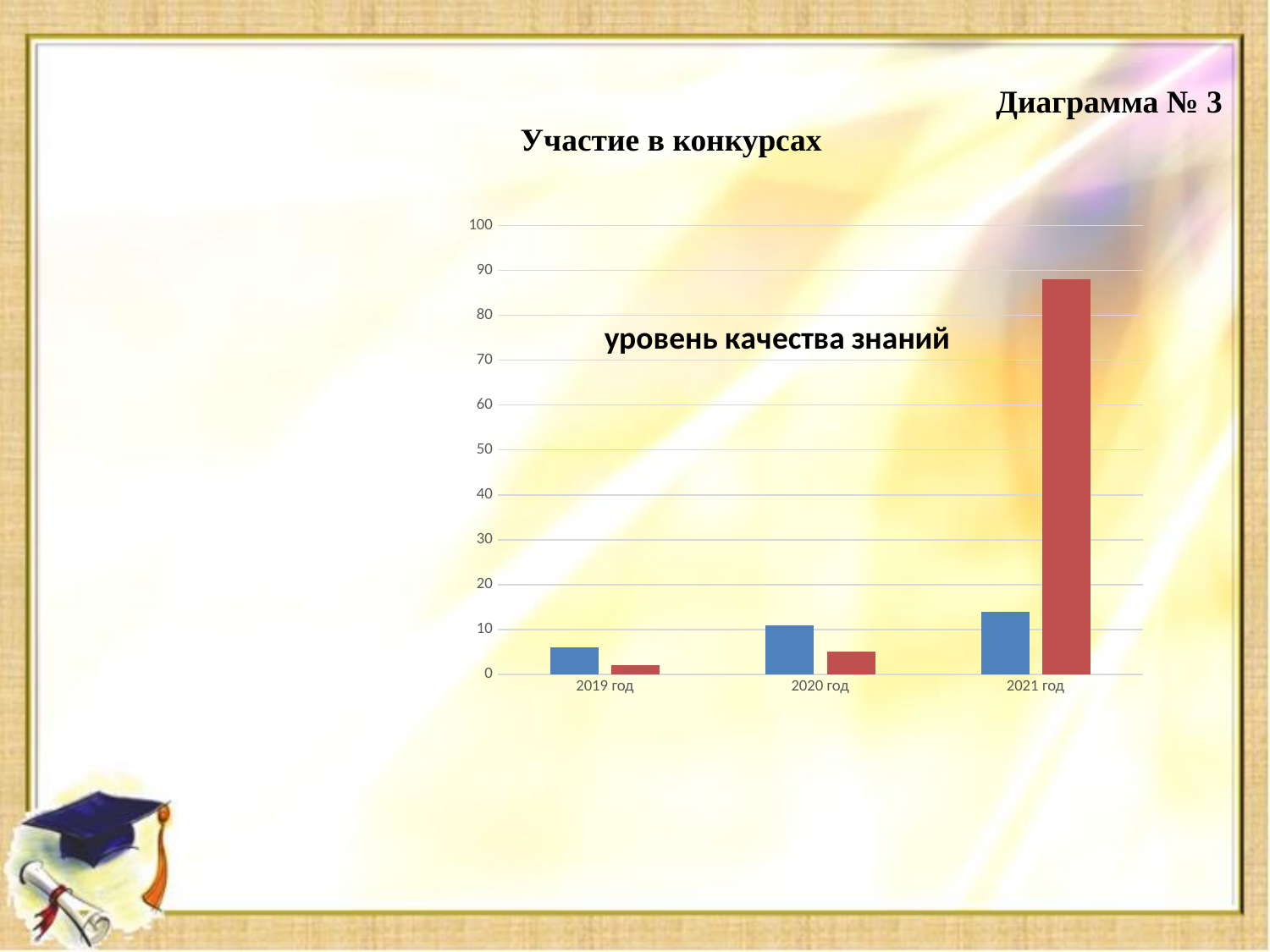
What is the heading printed above the chart on the slide? Участие в конкурсах Is the red bar for 2020 год greater or less than 10? less Is the blue bar for 2021 год greater or less than 20? less Is the blue bar for 2019 год greater or less than 10? less For 2021 год, which bar is taller, the blue one or the red one? the red one Which category has the tallest bar in the chart? 2021 год What title is printed inside the chart area? уровень качества знаний What kind of chart is shown on the slide? bar chart How many categories are shown on the x axis of the chart? 3 Do the blue bars rise or fall from 2019 год to 2021 год? rise Which category has the shortest red bar in the chart? 2019 год